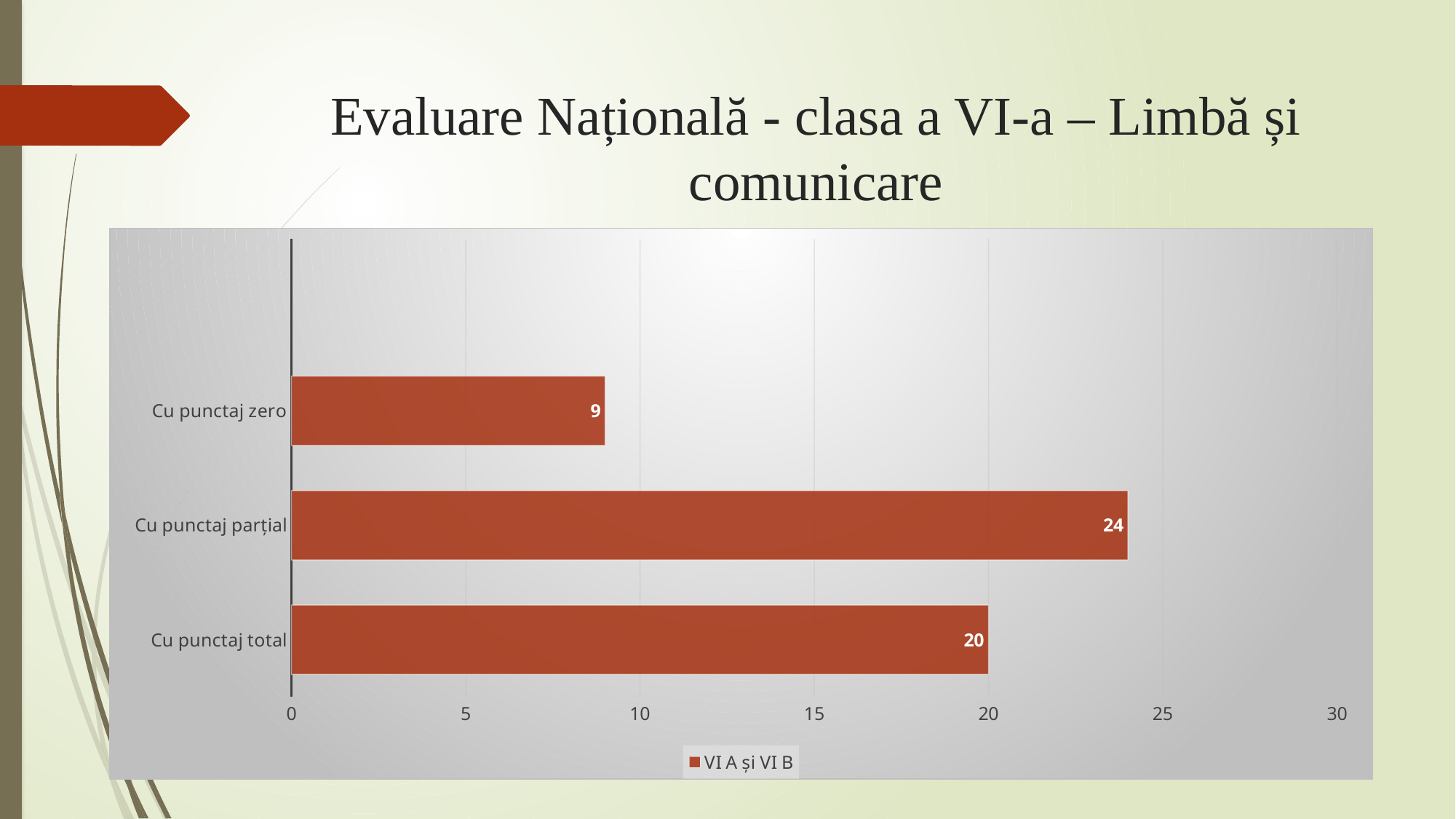
What is the value for "Cu punctaj zero"? 9 Which category has the highest value? Cu punctaj parțial Which is larger, the value for "Cu punctaj total" or the value for "Cu punctaj zero"? Cu punctaj total Is the value for "Cu punctaj parțial" greater or less than 20? greater What is the value for "Cu punctaj parțial"? 24 What is the difference between the values for "Cu punctaj total" and "Cu punctaj zero"? 11 What kind of chart is shown on the slide? bar chart How many series does the legend list? 1 Which category has the lowest value? Cu punctaj zero What is the value for "Cu punctaj total"? 20 How many categories are shown in the chart? 3 What is the difference between the values for "Cu punctaj parțial" and "Cu punctaj total"? 4